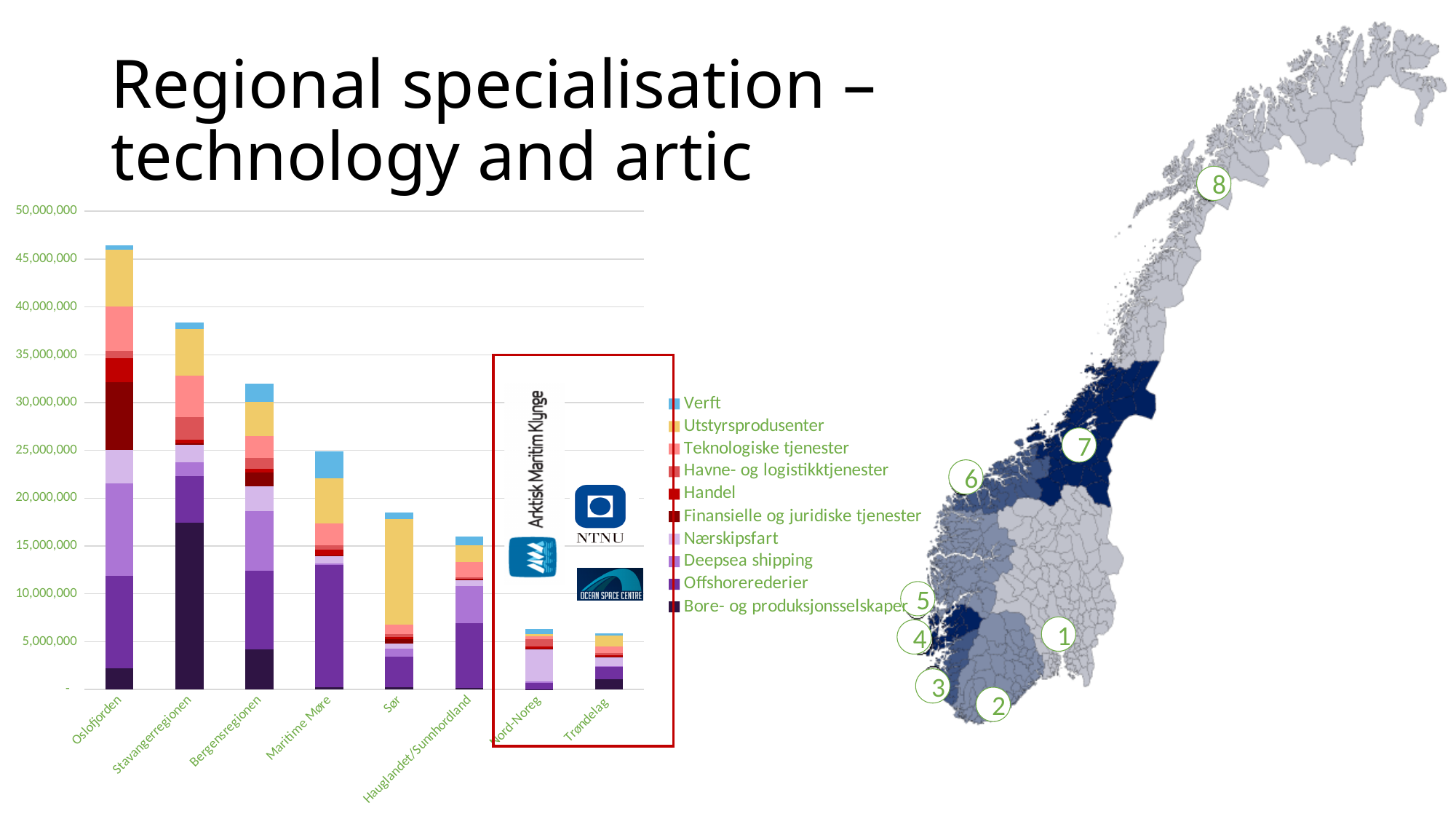
How many series does the chart legend list? 10 Which has the larger total bar, Sør or Hauglandet/Sunnhordland? Sør Is the total value for Nord-Noreg greater or less than 10,000,000? less Do the total bar heights generally rise or fall moving from left to right along the x axis? Fall Which region has the tallest stacked bar in the chart? Oslofjorden Which series is listed first in the chart legend? Verft Is the total value for Sør greater or less than 20,000,000? less Is the total value for Bergensregionen greater or less than 35,000,000? less What kind of chart is shown on the slide? Stacked bar chart How many regions (categories) are shown on the x axis of the chart? 8 Which has the larger total bar, Stavangerregionen or Bergensregionen? Stavangerregionen